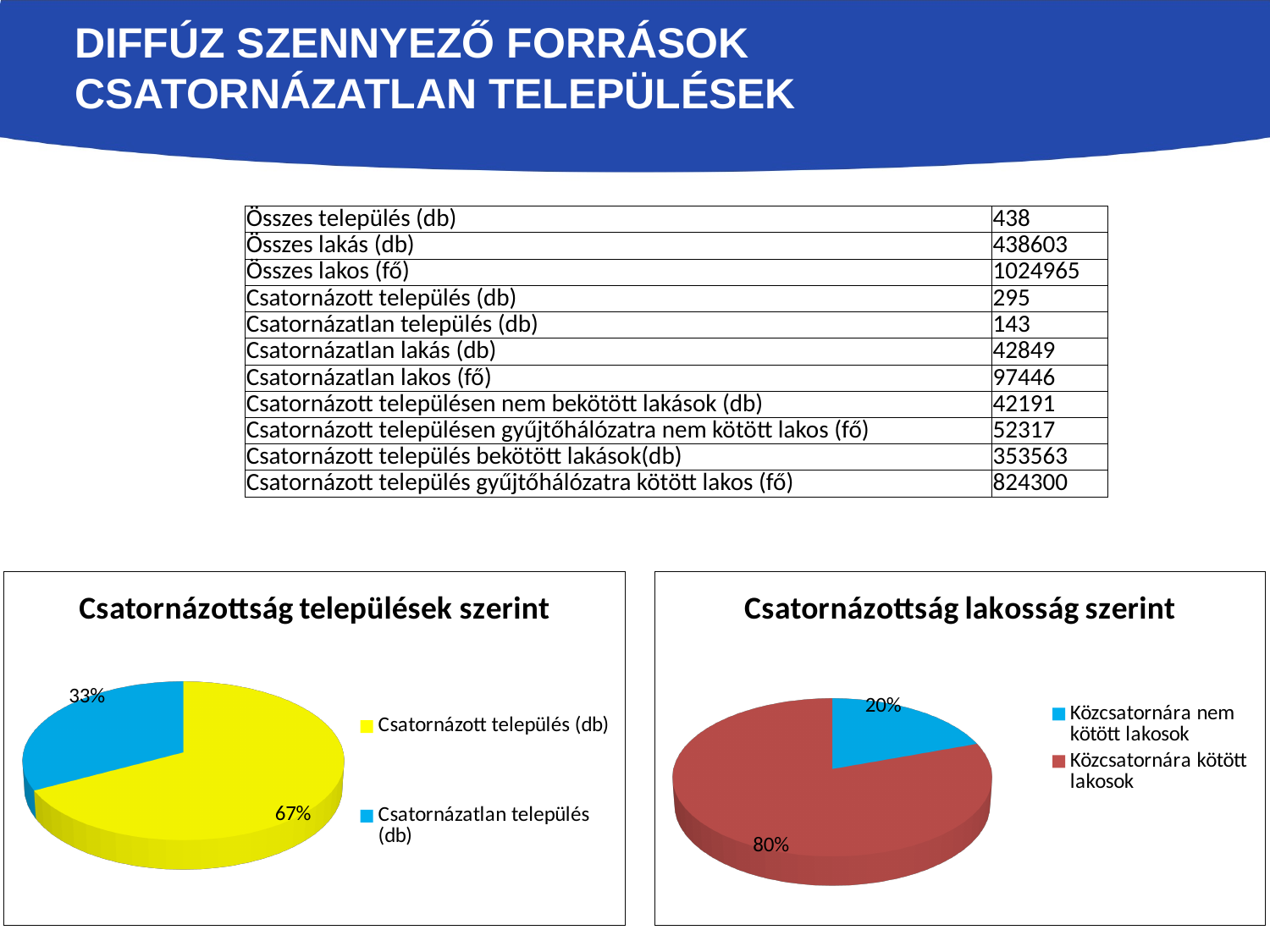
In the chart titled "Csatornázottság települések szerint", which category has the largest slice? Csatornázott település (db) In the chart titled "Csatornázottság lakosság szerint", what share of the pie is Közcsatornára kötött lakosok? 80% In the chart titled "Csatornázottság települések szerint", what is the difference in percentage points between the Csatornázott település (db) slice and the Csatornázatlan település (db) slice? 34 In the chart titled "Csatornázottság települések szerint", what share of the pie is Csatornázott település (db)? 67% In the chart titled "Csatornázottság lakosság szerint", which is larger: Közcsatornára kötött lakosok or Közcsatornára nem kötött lakosok? Közcsatornára kötött lakosok In the chart titled "Csatornázottság települések szerint", what share of the pie is Csatornázatlan település (db)? 33% What kind of chart is the chart titled "Csatornázottság települések szerint"? Pie chart How many slices does the chart titled "Csatornázottság lakosság szerint" have? 2 In the chart titled "Csatornázottság lakosság szerint", what is the difference in percentage points between the Közcsatornára kötött lakosok slice and the Közcsatornára nem kötött lakosok slice? 60 In the chart titled "Csatornázottság lakosság szerint", which category has the smallest slice? Közcsatornára nem kötött lakosok In the chart titled "Csatornázottság települések szerint", what colour is the Csatornázott település (db) slice? Yellow